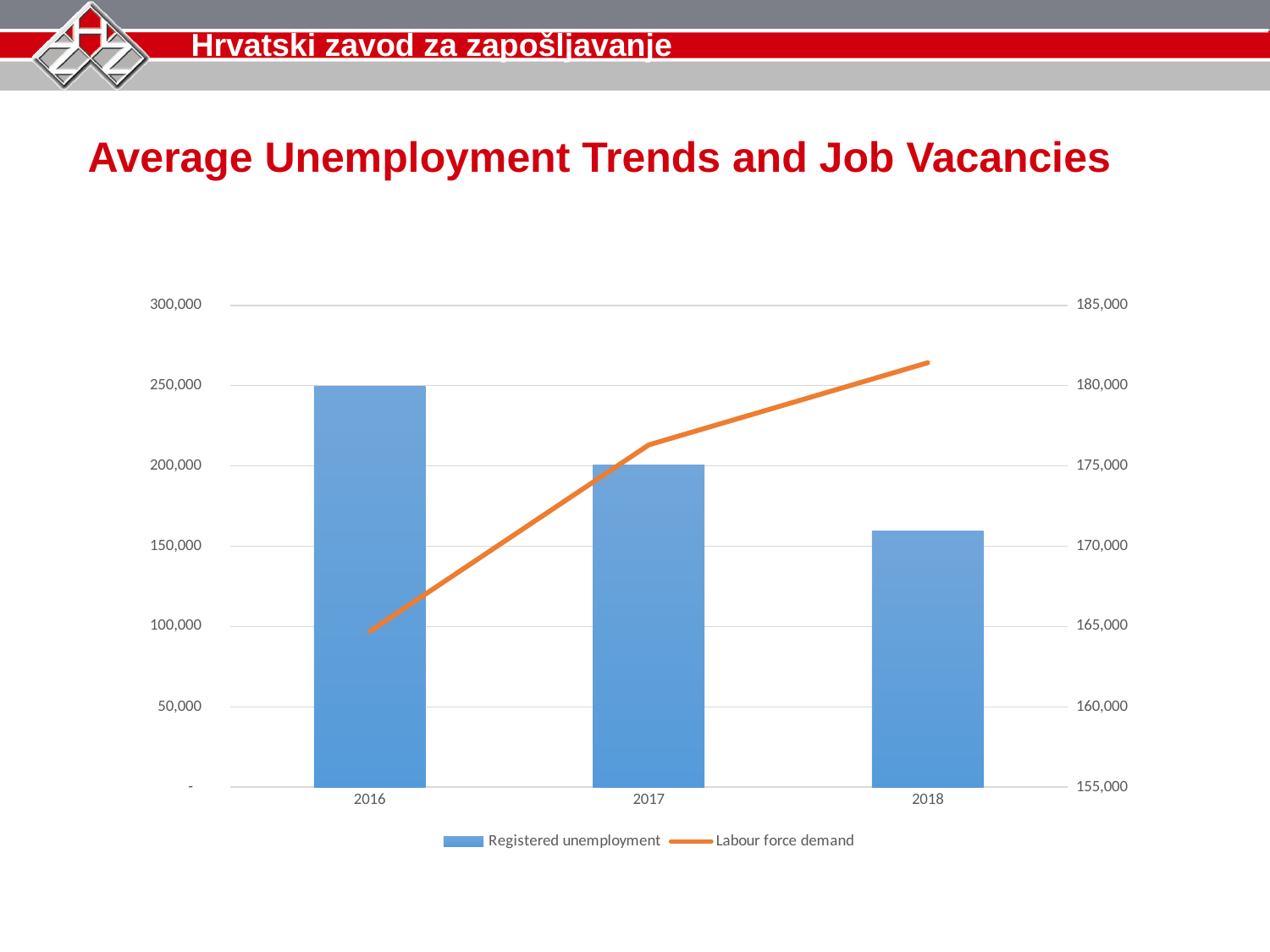
What kind of chart is shown on the slide? Combined bar and line chart Is the registered unemployment for 2018 greater or less than 200,000? less Is the labour force demand for 2016 greater or less than 170,000? less Is the labour force demand for 2018 greater or less than 180,000? greater Does registered unemployment rise or fall from 2016 to 2018? Fall Which series is shown as an orange line? Labour force demand How many years are shown on the x axis? 3 Which year has the lowest registered unemployment? 2018 How many series does the legend list? 2 Which year has the highest registered unemployment? 2016 Does labour force demand rise or fall from 2016 to 2018? Rise